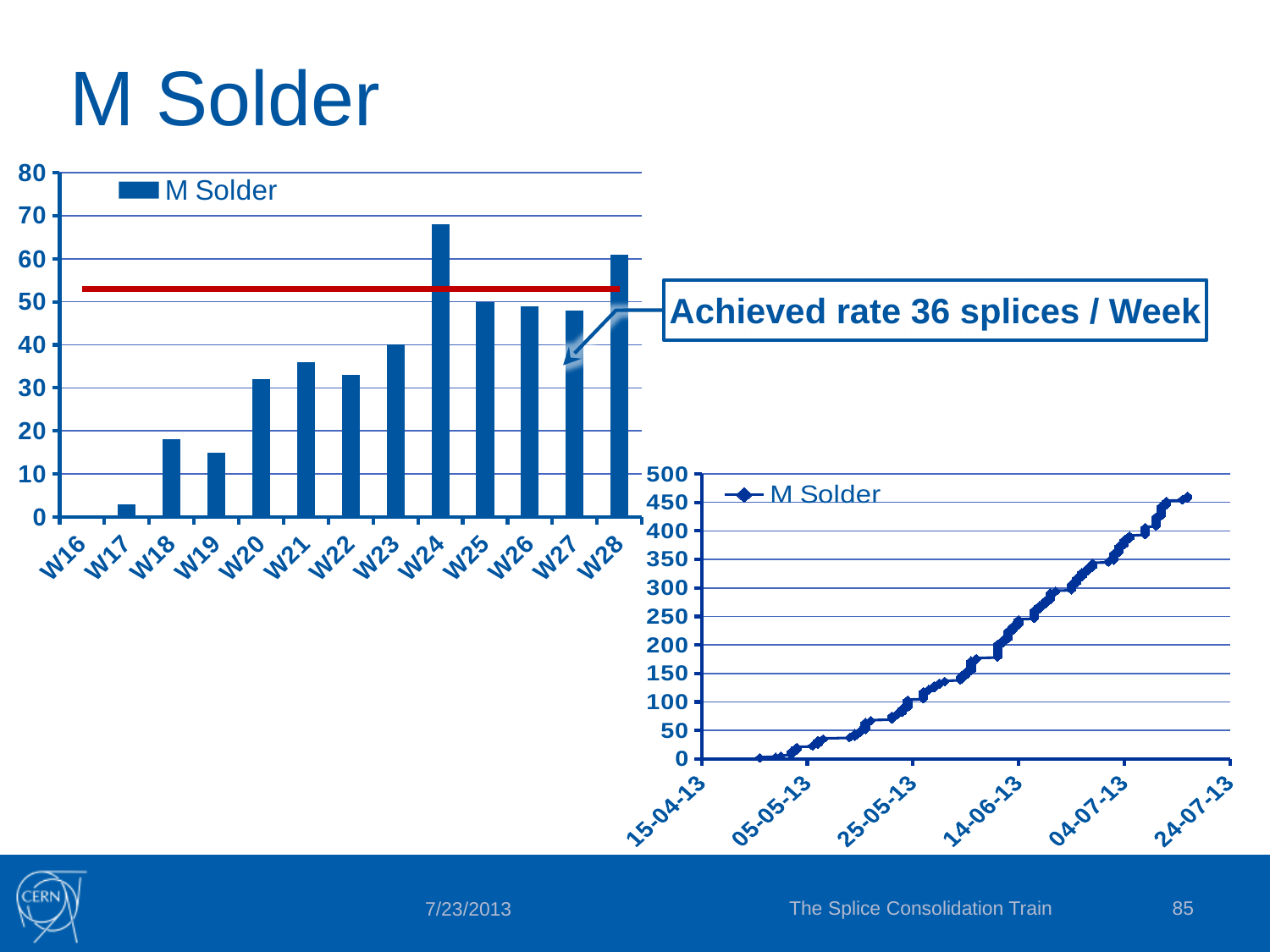
In the top-left bar chart, which week has the lowest value? W16 In the top-left bar chart, is the value for W28 greater or less than 50? greater In the bottom-right line chart, do the values rise or fall from left to right along the x axis? rise How many series does the legend of the top-left bar chart list? 1 What achieved rate does the text box next to the red line on the top-left chart state? 36 splices / Week In the top-left bar chart, is the value for W24 greater or less than 60? greater In the top-left bar chart, which is larger, the value for W20 or the value for W23? W23 How many weeks are shown on the x axis of the top-left bar chart? 13 In the top-left bar chart, is the value for W17 greater or less than 10? less What kind of chart is the bottom-right chart on the slide? line chart What kind of chart is the top-left chart on the slide? bar chart In the top-left bar chart, which week has the highest value? W24